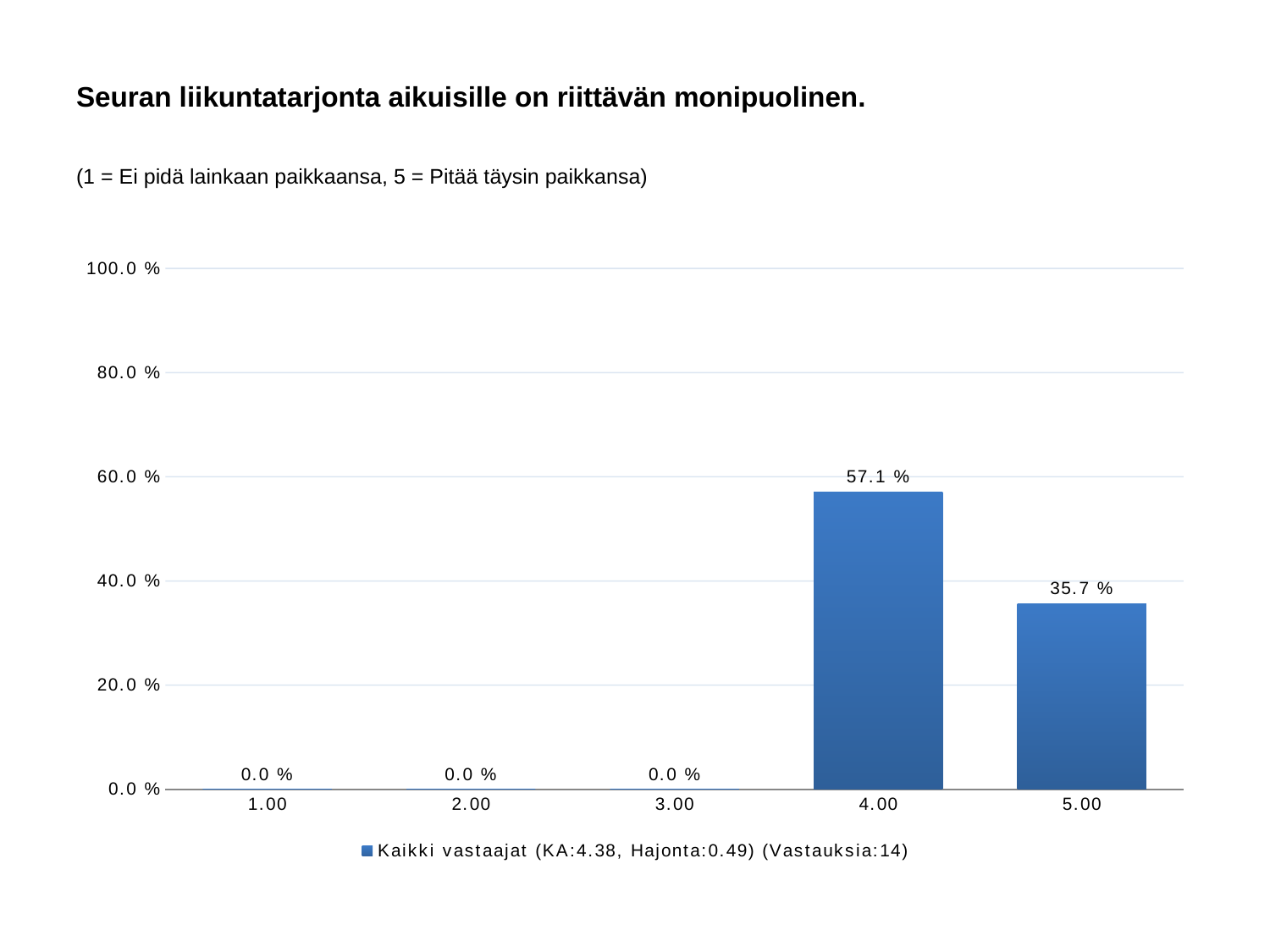
What is the value for category 1.00? 0.0 % Is the value for 4.00 greater or less than 40.0 %? greater What kind of chart is shown? bar chart What is the value for category 4.00? 57.1 % What is the value for category 5.00? 35.7 % Which category has the highest value? 4.00 Is the value for 5.00 greater or less than 40.0 %? less How many categories have a value of 0.0 %? 3 How many categories are shown on the x axis? 5 Which is larger, the value for 4.00 or the value for 5.00? 4.00 What is the difference between the values for 4.00 and 5.00? 21.4 % How many series does the legend list? 1